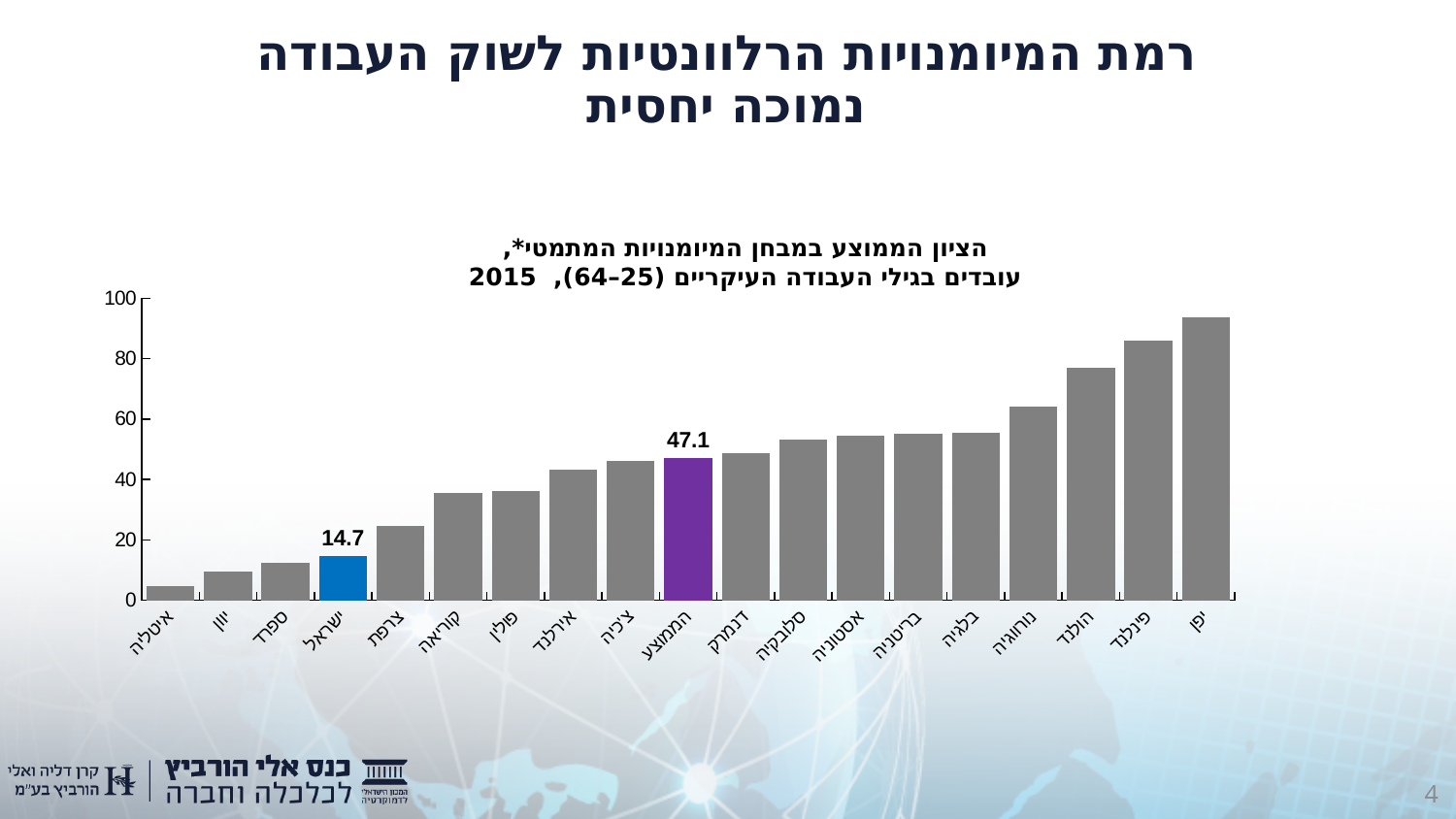
Do the bar values rise or fall from left to right along the x axis? Rise What is the value shown for הממוצע (the average)? 47.1 What is the difference between the value for הממוצע and the value for ישראל? 32.4 What is the value shown for ישראל (Israel)? 14.7 How many bars are plotted in the chart? 19 Which country has the highest bar in the chart? יפן Which is larger, the value for ישראל or the value for הממוצע? הממוצע Which country has the lowest bar in the chart? איטליה Is the value for הולנד greater or less than 60? greater What kind of chart is shown on the slide? Bar chart What colour is the bar for ישראל? Blue Is the value for יפן greater or less than 80? greater